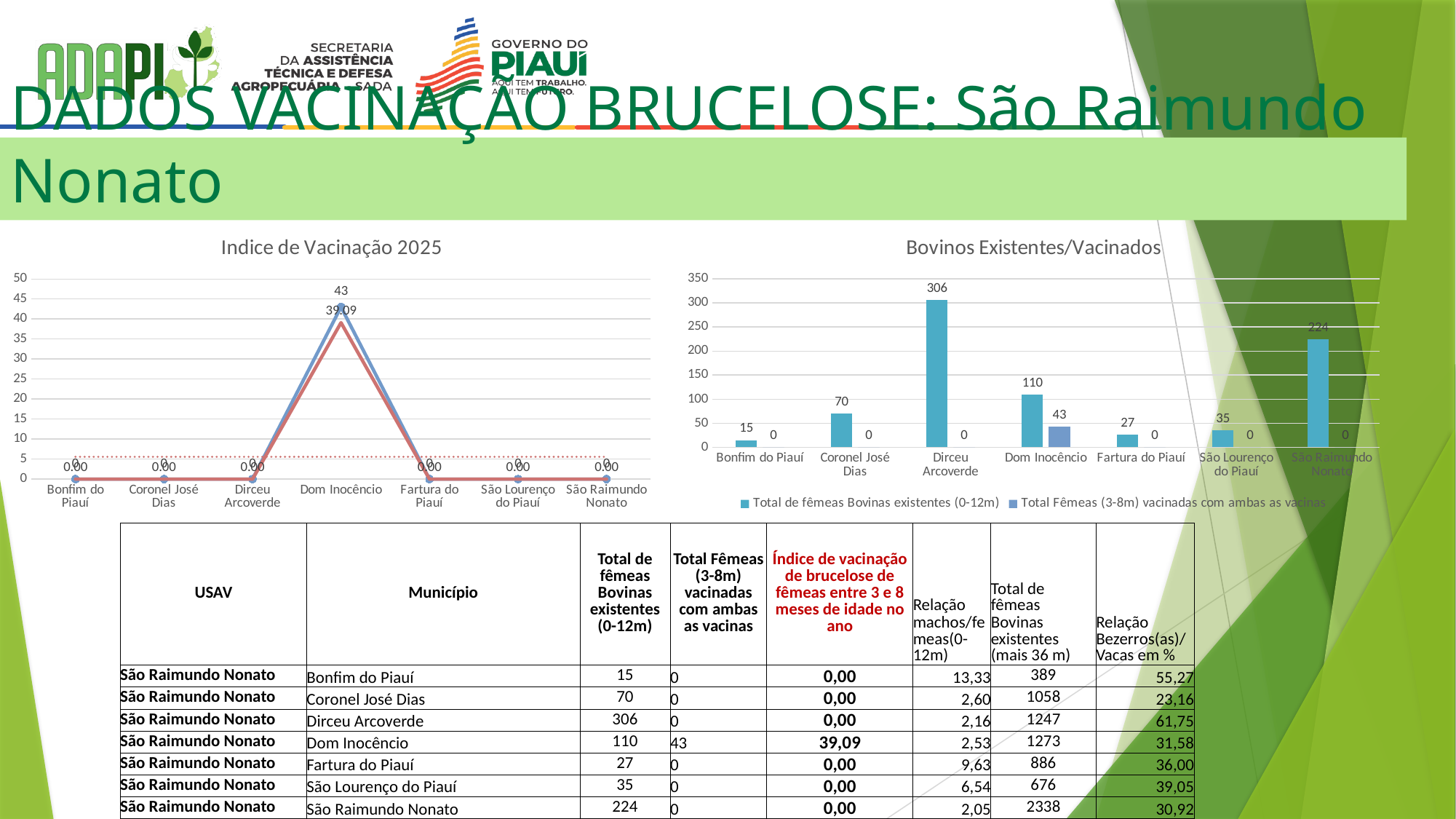
In the 'Bovinos Existentes/Vacinados' chart, how many series does the legend list? 2 What kind of chart is 'Bovinos Existentes/Vacinados'? Bar chart In the 'Bovinos Existentes/Vacinados' chart, what is the value of 'Total de fêmeas Bovinas existentes (0-12m)' for Dirceu Arcoverde? 306 In the 'Indice de Vacinação 2025' chart, which municipality has the highest value? Dom Inocêncio In the 'Bovinos Existentes/Vacinados' chart, which is larger: the 'Total de fêmeas Bovinas existentes (0-12m)' value for Coronel José Dias or for Dom Inocêncio? Dom Inocêncio In the 'Bovinos Existentes/Vacinados' chart, what is the difference between the 'Total de fêmeas Bovinas existentes (0-12m)' values for Dirceu Arcoverde and São Raimundo Nonato? 82 In the 'Bovinos Existentes/Vacinados' chart, which municipality has the lowest value for 'Total de fêmeas Bovinas existentes (0-12m)'? Bonfim do Piauí In the 'Indice de Vacinação 2025' chart, what is the labelled value of the red line for Dom Inocêncio? 39.09 How many municipalities are shown on the x axis of the 'Bovinos Existentes/Vacinados' chart? 7 In the 'Bovinos Existentes/Vacinados' chart, which municipality has the highest value for 'Total de fêmeas Bovinas existentes (0-12m)'? Dirceu Arcoverde In the 'Bovinos Existentes/Vacinados' chart, what is the value of 'Total Fêmeas (3-8m) vacinadas com ambas as vacinas' for Dom Inocêncio? 43 What kind of chart is 'Indice de Vacinação 2025'? Line chart